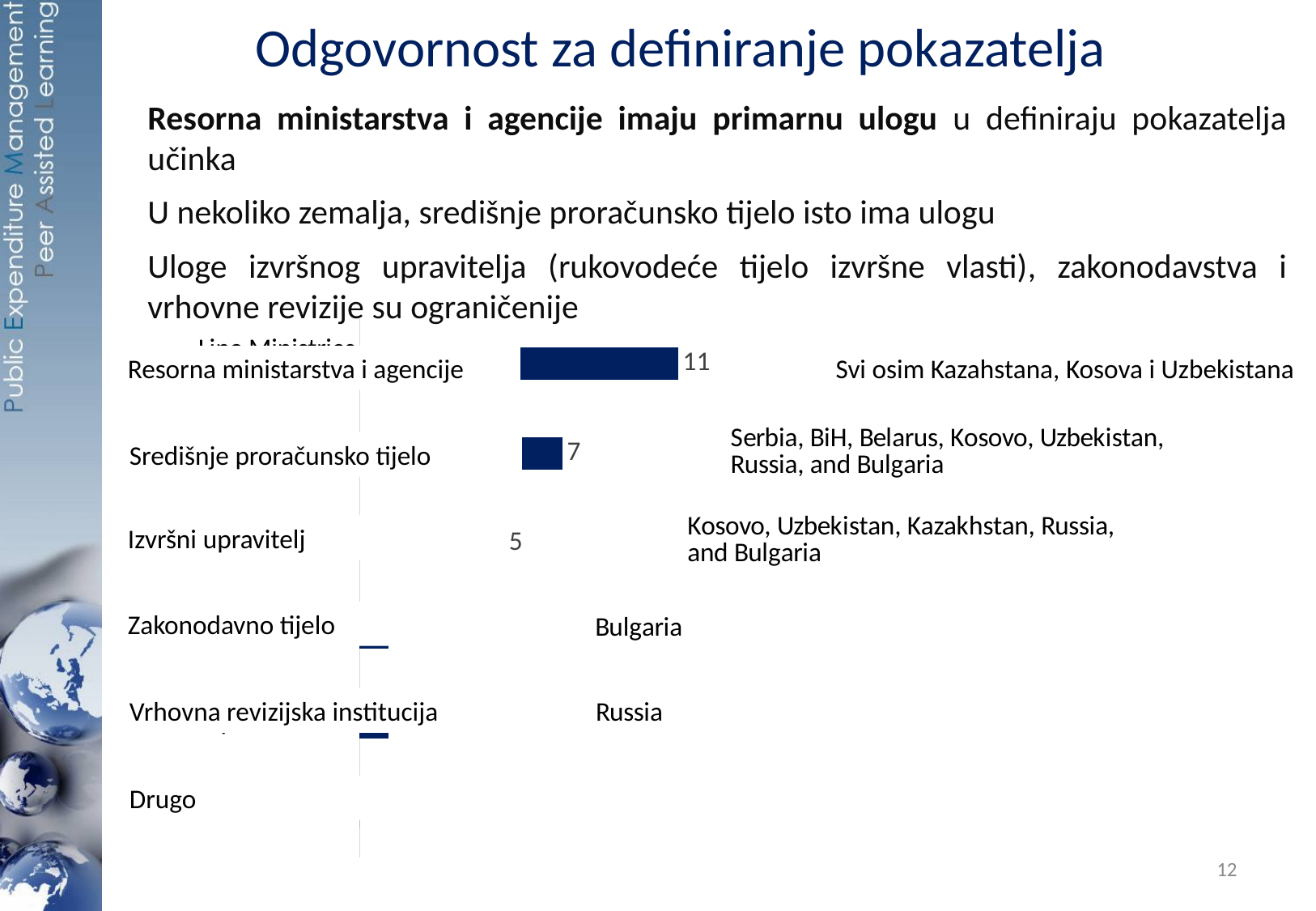
Which is larger, the value for Središnje proračunsko tijelo or the value for Izvršni upravitelj? Središnje proračunsko tijelo What kind of chart is shown on the slide? Bar chart Which category has the highest value? Resorna ministarstva i agencije How many categories are listed on the chart? 6 What is the value for Izvršni upravitelj? 5 Which is larger, the value for Resorna ministarstva i agencije or the value for Zakonodavno tijelo? Resorna ministarstva i agencije What is the value for Resorna ministarstva i agencije? 11 What is the value for Središnje proračunsko tijelo? 7 What is the difference between the values for Središnje proračunsko tijelo and Izvršni upravitelj? 2 Which countries are listed next to the Zakonodavno tijelo bar? Bulgaria What is the difference between the values for Resorna ministarstva i agencije and Središnje proračunsko tijelo? 4 What is the difference between the values for Resorna ministarstva i agencije and Izvršni upravitelj? 6